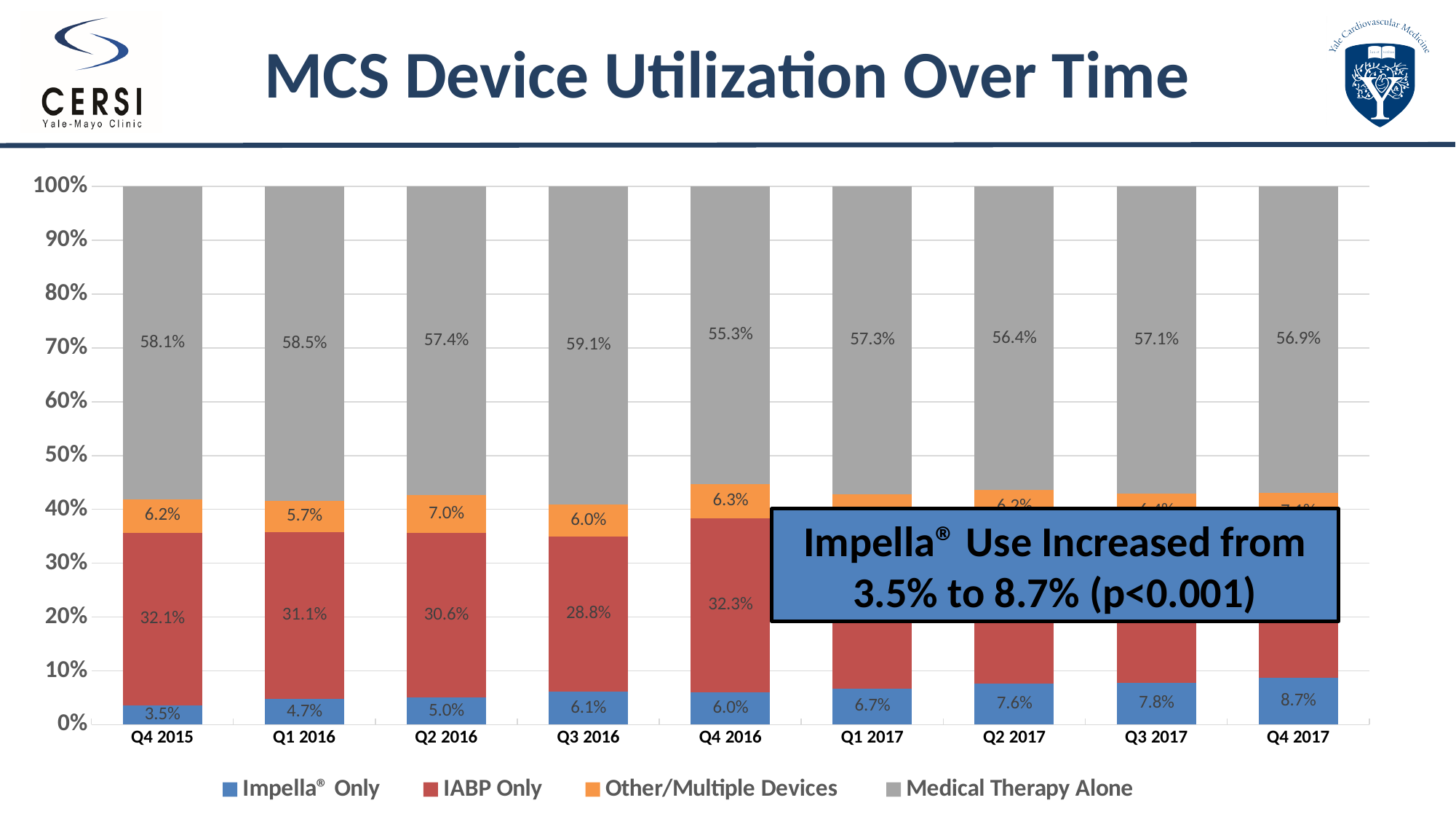
What is the Other/Multiple Devices value for Q2 2016? 7.0% What is the Impella Only value for Q4 2017? 8.7% What is the difference between the Impella Only values for Q4 2017 and Q4 2015? 5.2% Which is larger, the IABP Only value for Q1 2016 or for Q3 2016? Q1 2016 How many series does the legend list? 4 What is the IABP Only value for Q4 2016? 32.3% What type of chart is shown on the slide? Stacked bar chart What is the Medical Therapy Alone value for Q3 2016? 59.1% Which quarter has the highest Impella Only value? Q4 2017 Which quarter has the lowest Medical Therapy Alone value? Q4 2016 What is the Impella Only value for Q4 2015? 3.5% How many quarters are shown on the x axis? 9